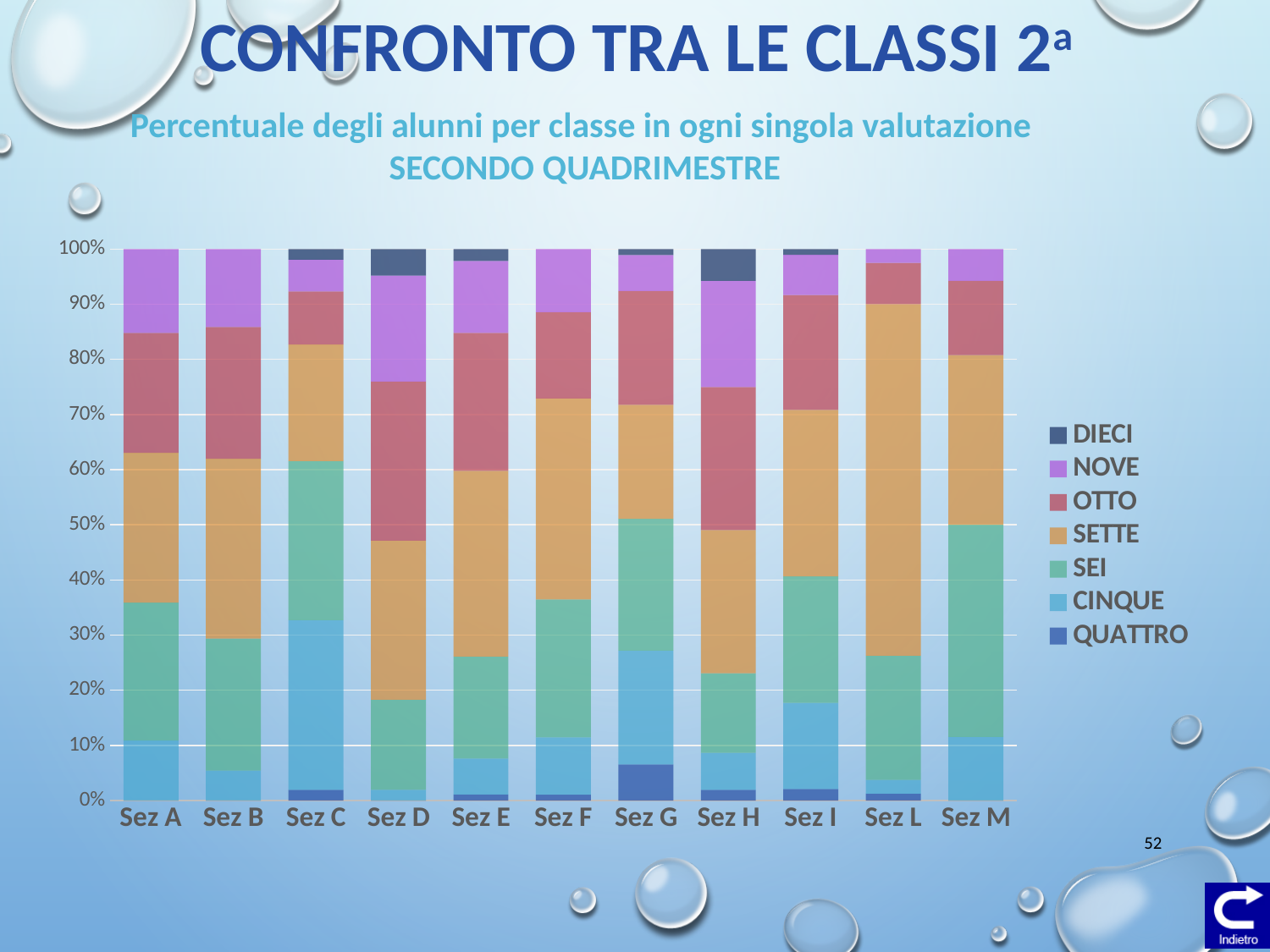
Is the SEI segment for Sez M greater or less than 30%? greater Is the CINQUE segment for Sez C greater or less than 20%? greater Which series is listed first (at the top) in the chart legend? DIECI Which section has the larger SEI segment, Sez M or Sez B? Sez M Is the SETTE segment for Sez L greater or less than 50%? greater Which section has the largest SETTE segment? Sez L What is the total of the stacked bar for Sez A? 100% How many classes (sections) are shown along the x axis of the chart? 11 Which section has the largest CINQUE segment? Sez C How many series does the chart legend list? 7 What kind of chart is shown on the slide? stacked bar chart What is the subtitle shown above the chart, below 'Percentuale degli alunni per classe in ogni singola valutazione'? SECONDO QUADRIMESTRE